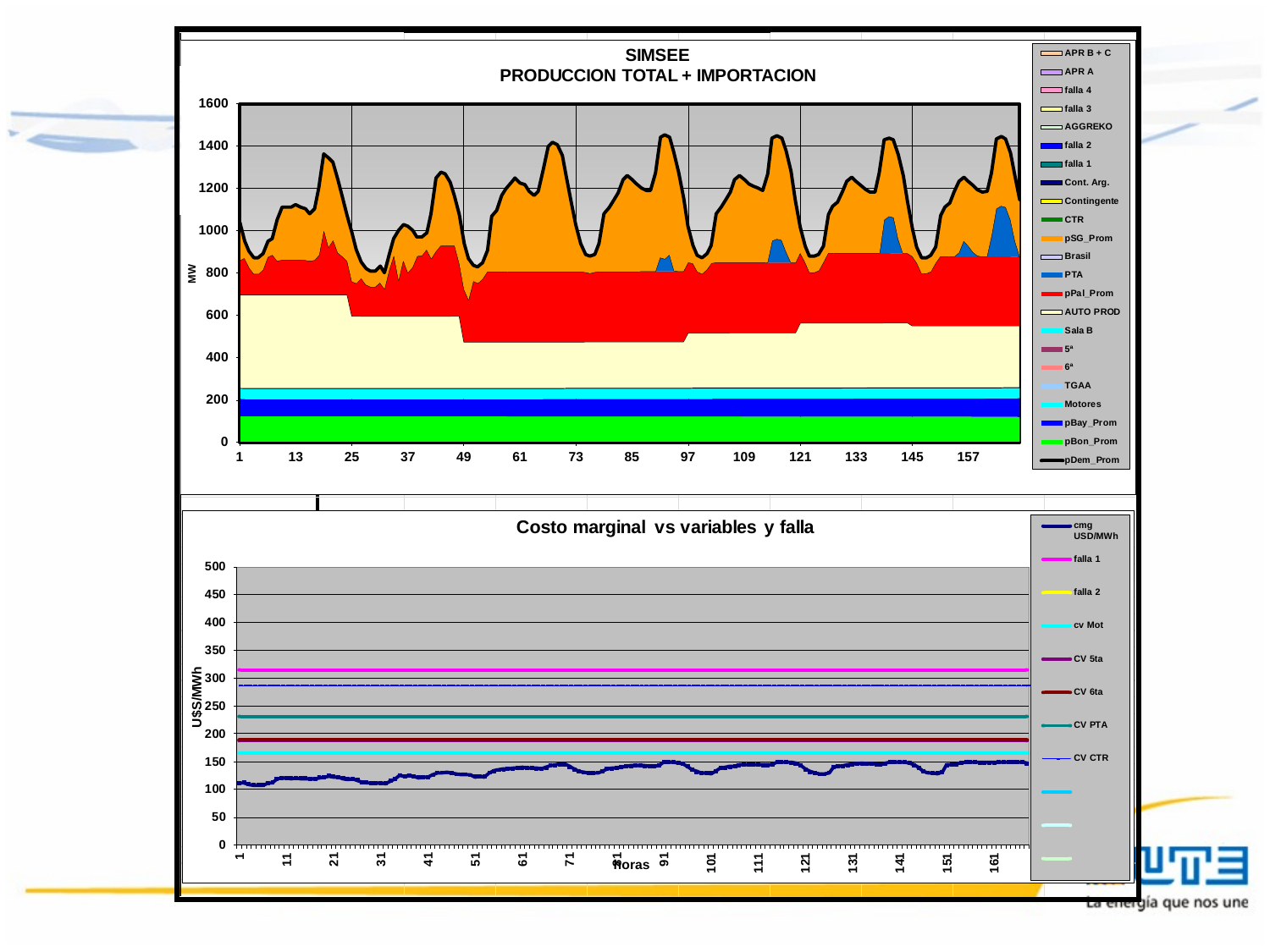
What kind of chart is the bottom chart, 'Costo marginal vs variables y falla'? line chart What is the title of the bottom chart? Costo marginal vs variables y falla In the bottom chart 'Costo marginal vs variables y falla', is the value of the CV 6ta line greater or less than 200? less In the bottom chart 'Costo marginal vs variables y falla', which line is higher, falla 1 or CV CTR? falla 1 In the bottom chart 'Costo marginal vs variables y falla', which line is higher, CV PTA or cv Mot? CV PTA In the top chart 'SIMSEE PRODUCCION TOTAL + IMPORTACION', how many series does the legend list? 23 What kind of chart is the top chart, 'SIMSEE PRODUCCION TOTAL + IMPORTACION'? stacked area chart In the top chart 'SIMSEE PRODUCCION TOTAL + IMPORTACION', is the highest peak of the pDem_Prom line greater or less than 1400? greater In the bottom chart 'Costo marginal vs variables y falla', is the value of the CV CTR line greater or less than 300? less What is the title of the top chart? SIMSEE PRODUCCION TOTAL + IMPORTACION